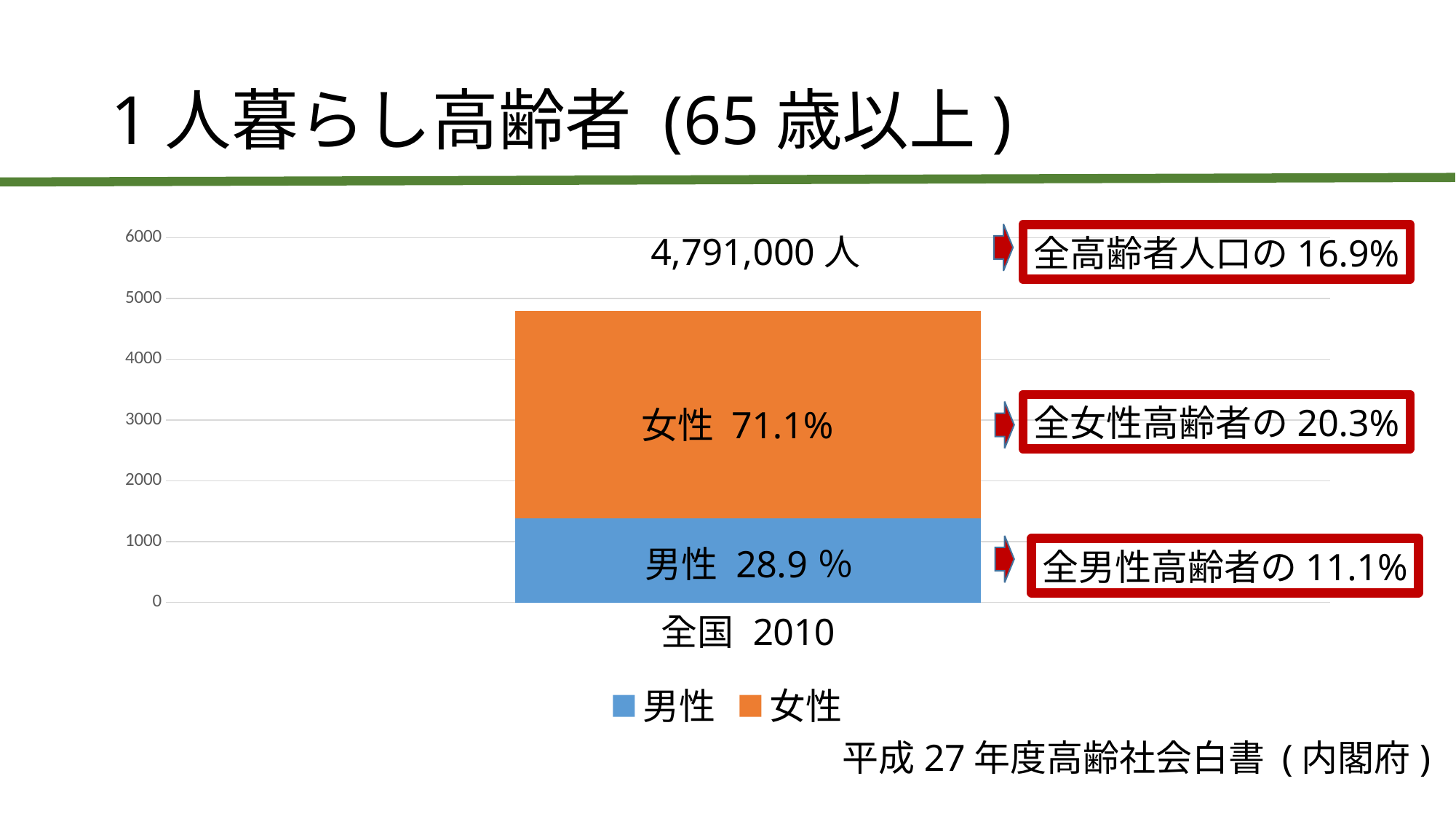
Is the 男性 segment of the bar greater or less than 2000 on the y axis? less Which colour represents 男性 in the chart? blue What is the highest value shown on the y axis? 6000 What total number of people is printed above the stacked bar? 4,791,000 人 Which segment of the stacked bar is larger, 男性 or 女性? 女性 Is the top of the stacked bar greater or less than 4000 on the y axis? greater What percentage is printed on the 女性 segment of the bar? 71.1% How many series does the legend list? 2 What is the category label on the x axis? 全国 2010 What percentage is printed on the 男性 segment of the bar? 28.9 % How many categories are plotted on the x axis? 1 What kind of chart is shown on the slide? bar chart